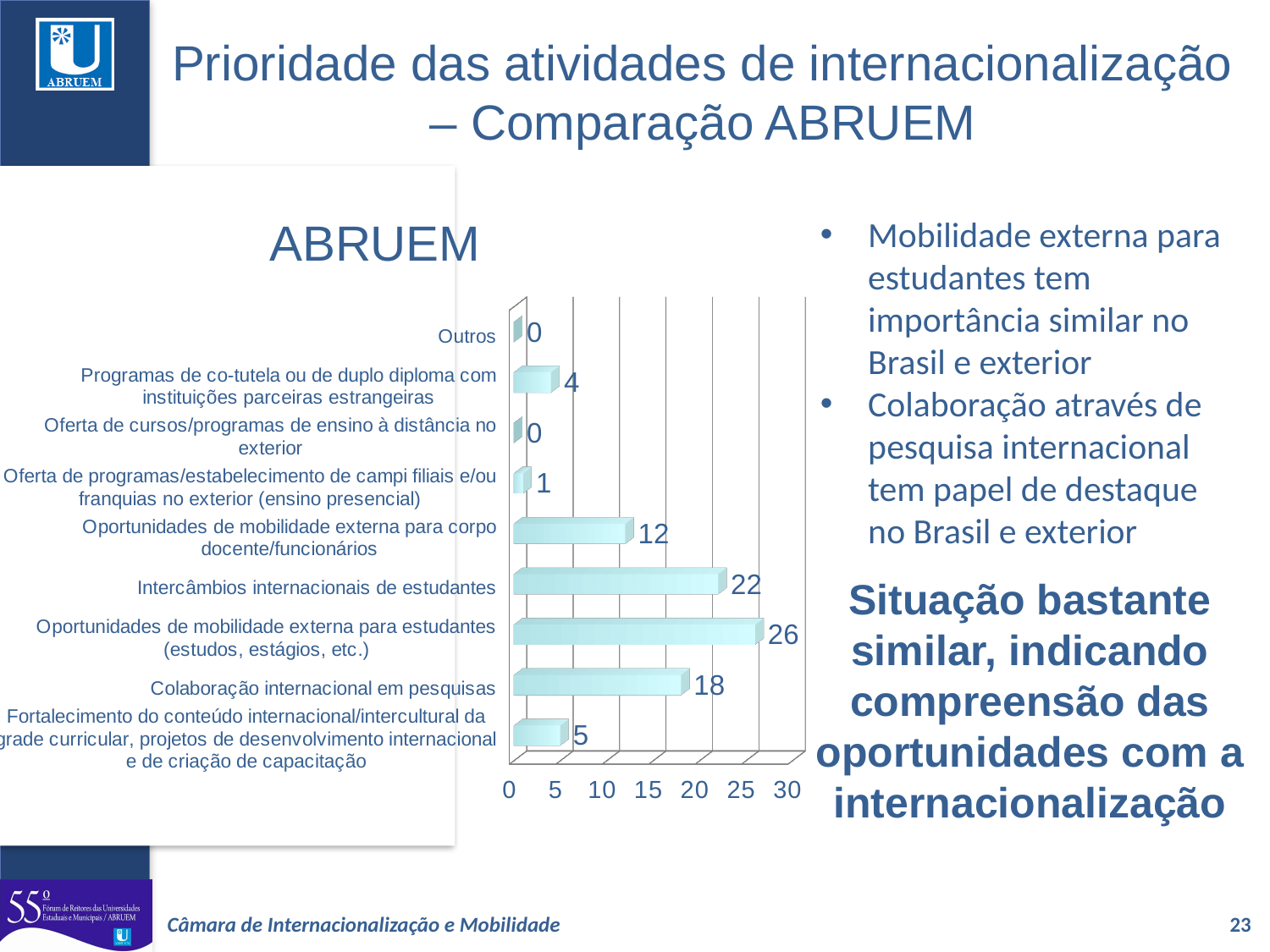
What kind of chart is the ABRUEM chart? Bar chart How many categories are shown in the ABRUEM chart? 9 Which category has the highest value in the ABRUEM chart? Oportunidades de mobilidade externa para estudantes (estudos, estágios, etc.) What is the title of the chart on the slide? ABRUEM What is the value for "Oportunidades de mobilidade externa para corpo docente/funcionários" in the ABRUEM chart? 12 What is the value for "Intercâmbios internacionais de estudantes" in the ABRUEM chart? 22 What is the value for "Programas de co-tutela ou de duplo diploma com instituições parceiras estrangeiras" in the ABRUEM chart? 4 What is the value for "Colaboração internacional em pesquisas" in the ABRUEM chart? 18 What is the difference between the values for "Colaboração internacional em pesquisas" and "Oportunidades de mobilidade externa para corpo docente/funcionários" in the ABRUEM chart? 6 What is the difference between the values for "Oportunidades de mobilidade externa para estudantes" and "Intercâmbios internacionais de estudantes" in the ABRUEM chart? 4 What is the value for "Outros" in the ABRUEM chart? 0 Which has a larger value in the ABRUEM chart: "Colaboração internacional em pesquisas" or "Fortalecimento do conteúdo internacional/intercultural da grade curricular"? Colaboração internacional em pesquisas